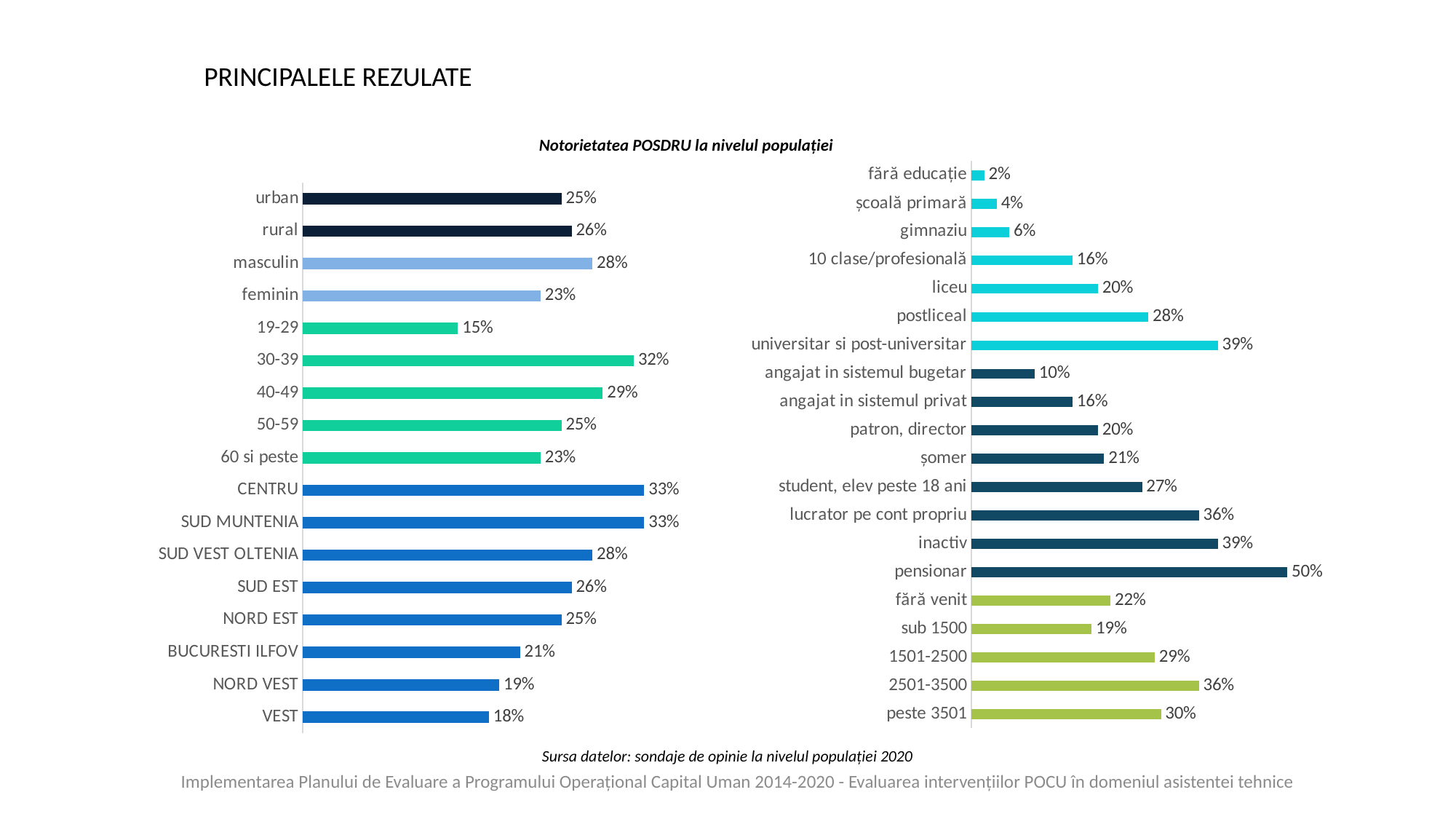
In the right chart, which is larger, the value for lucrator pe cont propriu or the value for student, elev peste 18 ani? lucrator pe cont propriu In the right chart, what is the value for liceu? 20% In the left chart, what is the value for BUCURESTI ILFOV? 21% In the right chart, what is the value for pensionar? 50% In the left chart, what is the value for masculin? 28% In the left chart, which category has the lowest value? VEST What kind of chart is the left chart? bar chart In the right chart, which category has the highest value? pensionar How many categories are shown in the right chart? 20 In the left chart, what is the difference between the values for 30-39 and 19-29? 17% In the right chart, which category has the lowest value? fără educație What is the title shown above the two charts? Notorietatea POSDRU la nivelul populației